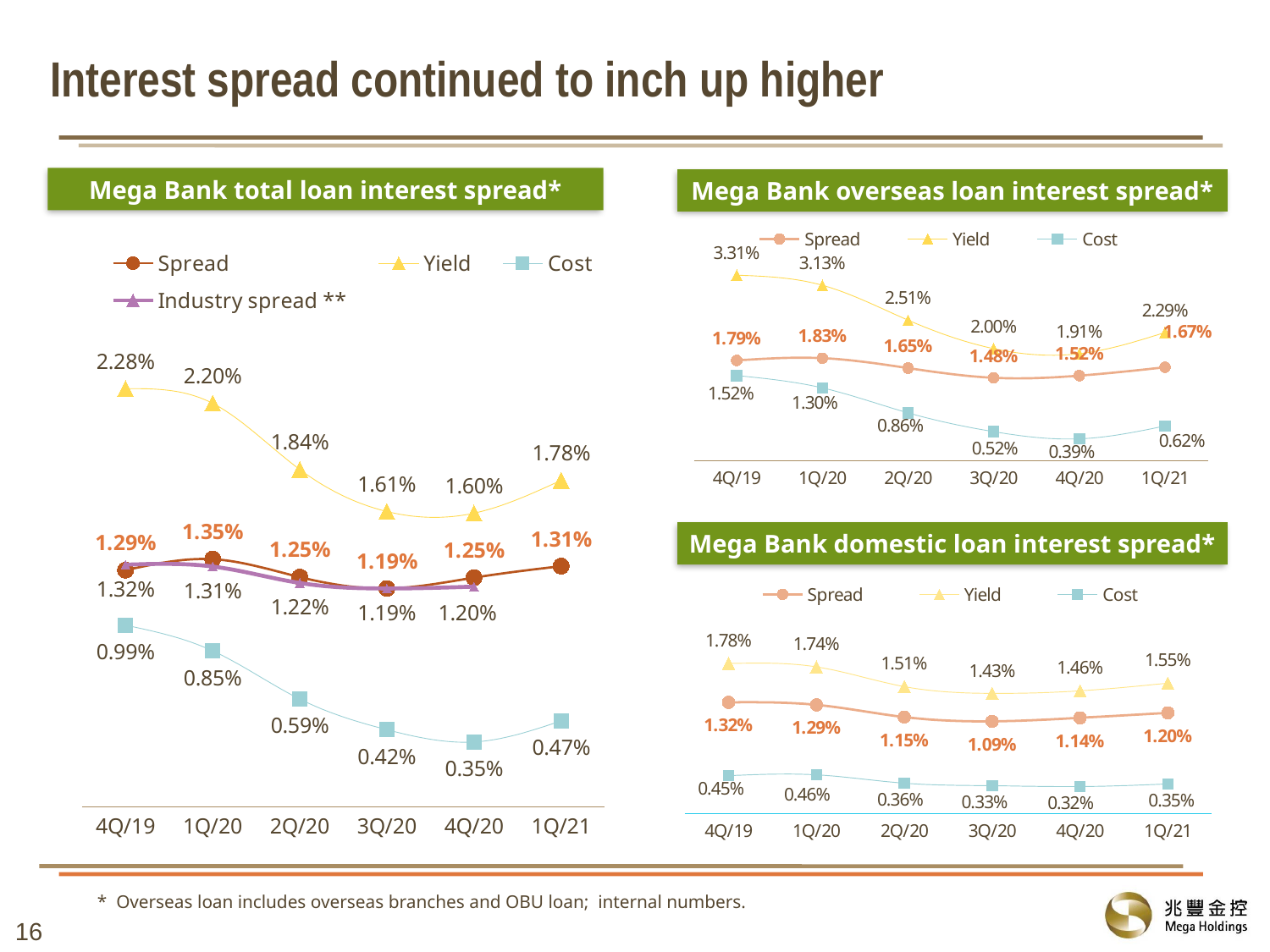
In the Mega Bank total loan interest spread chart, what is the difference between the Yield and the Cost in 4Q/19? 1.29% In the Mega Bank domestic loan interest spread chart, which is larger: the Cost in 4Q/19 or the Cost in 1Q/20? 1Q/20 In the Mega Bank domestic loan interest spread chart, does the Yield rise or fall from 4Q/19 to 3Q/20? fall In the Mega Bank total loan interest spread chart, what is the Spread value for 1Q/21? 1.31% In the Mega Bank total loan interest spread chart, how many series does the legend list? 4 In the Mega Bank overseas loan interest spread chart, how many quarters are shown on the x axis? 6 In the Mega Bank domestic loan interest spread chart, what is the Spread value for 3Q/20? 1.09% In the Mega Bank overseas loan interest spread chart, in which quarter is the Spread highest? 1Q/20 In the Mega Bank overseas loan interest spread chart, what is the Yield value for 4Q/19? 3.31% In the Mega Bank total loan interest spread chart, what is the Industry spread value for 2Q/20? 1.22% What type of chart is the Mega Bank domestic loan interest spread chart? line chart In the Mega Bank total loan interest spread chart, in which quarter is the Cost lowest? 4Q/20